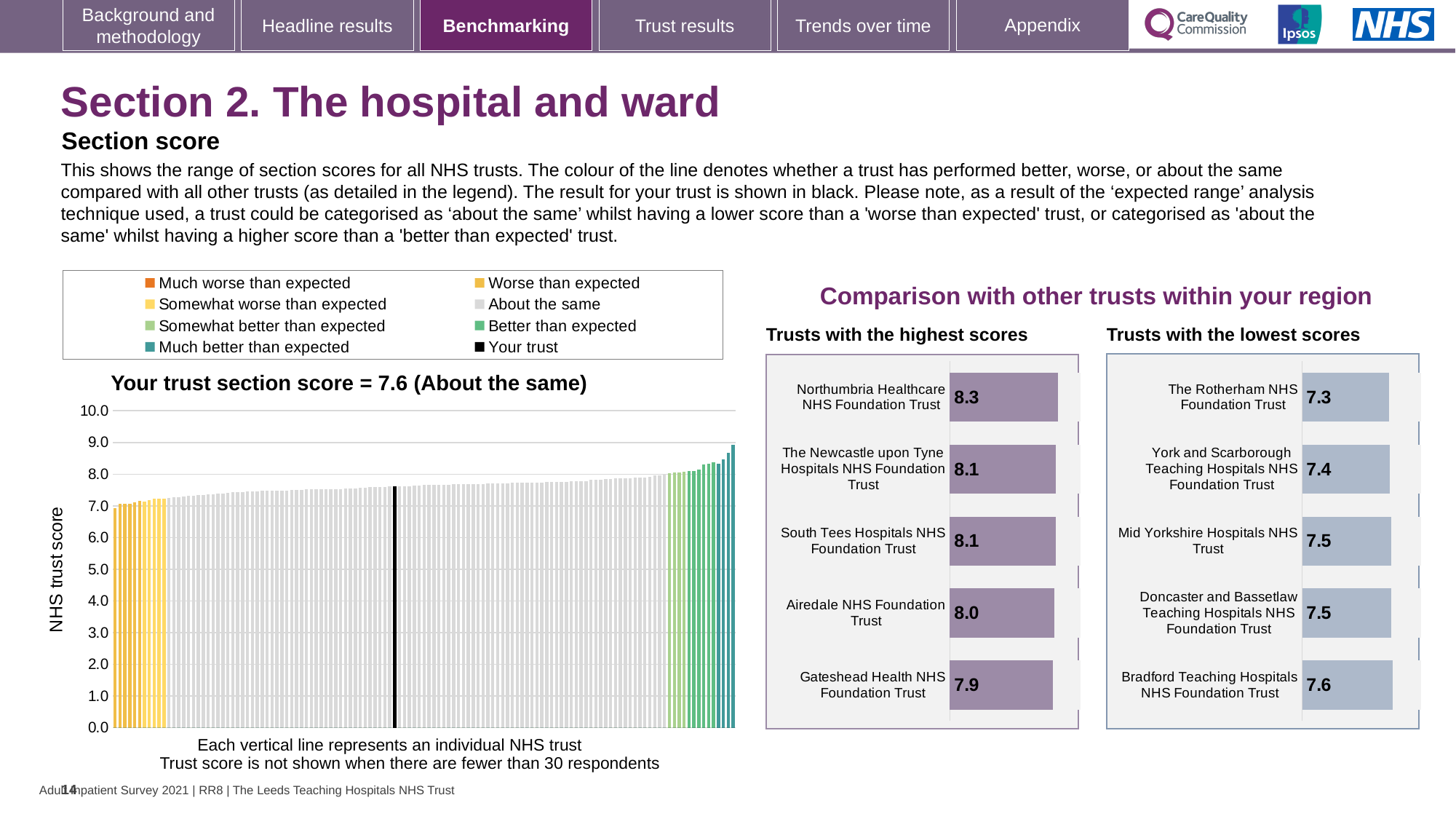
In the 'Trusts with the highest scores' chart, which trust has the highest score? Northumbria Healthcare NHS Foundation Trust In the 'Trusts with the lowest scores' chart, what is the score for The Rotherham NHS Foundation Trust? 7.3 In the 'Your trust section score' chart, do the bar values rise or fall from left to right? rise In the 'Trusts with the lowest scores' chart, what is the score for Bradford Teaching Hospitals NHS Foundation Trust? 7.6 In the 'Trusts with the highest scores' chart, what is the difference between the scores of Northumbria Healthcare NHS Foundation Trust and Gateshead Health NHS Foundation Trust? 0.4 In the 'Your trust section score' chart, what is the section score for your trust? 7.6 What kind of chart is the 'Your trust section score' chart? bar chart In the 'Trusts with the lowest scores' chart, how many trusts are shown? 5 In the 'Trusts with the highest scores' chart, what is the score for Gateshead Health NHS Foundation Trust? 7.9 In the 'Trusts with the highest scores' chart, what is the score for Northumbria Healthcare NHS Foundation Trust? 8.3 In the 'Trusts with the lowest scores' chart, which trust has the lowest score? The Rotherham NHS Foundation Trust How many entries does the legend above the 'Your trust section score' chart list? 8